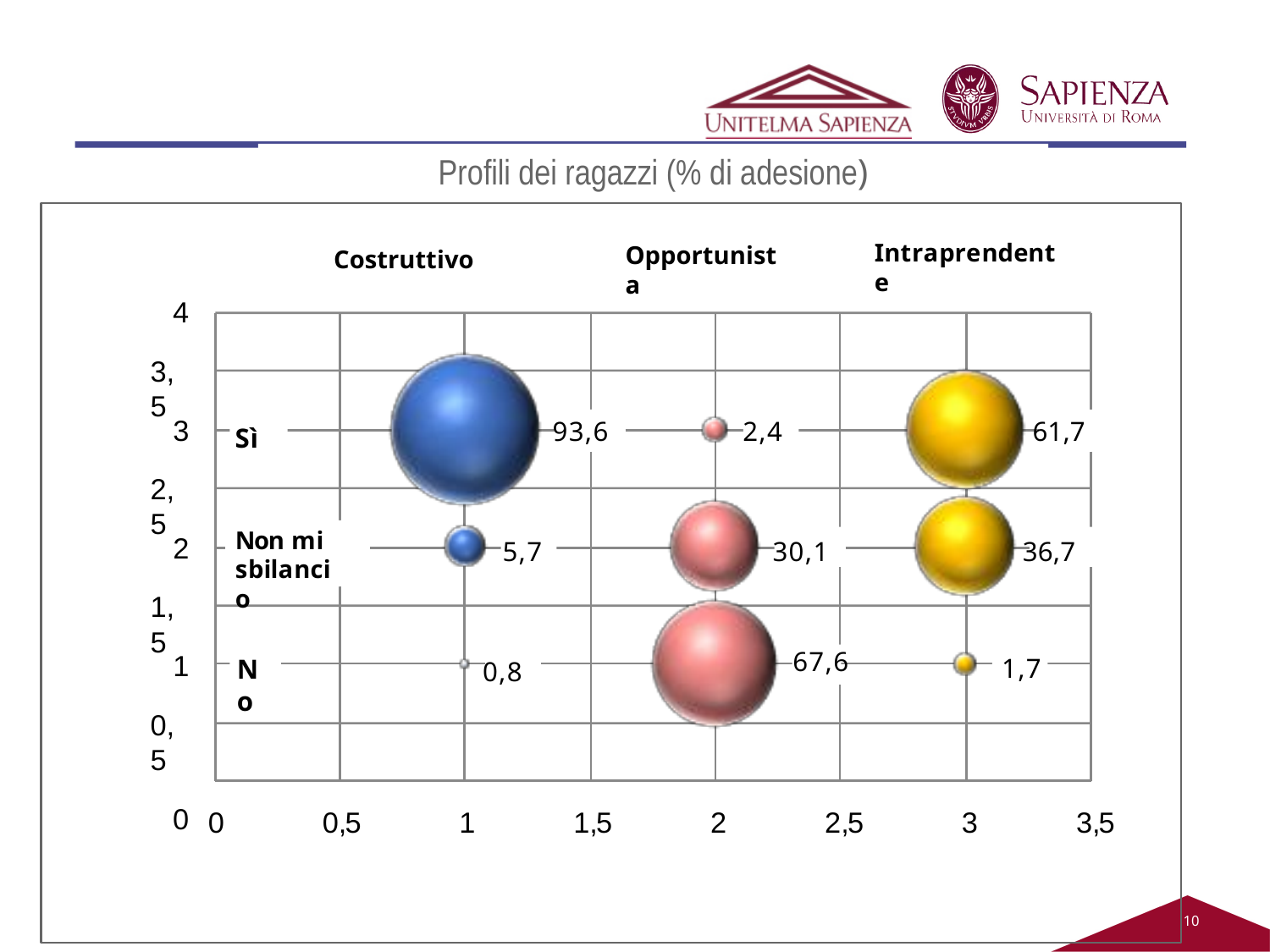
What is the value for Costruttivo in the Sì row? 93,6 Which profile has the largest bubble in the Sì row? Costruttivo What is the total of the three values for Opportunista? 100,1 What is the title of the chart? Profili dei ragazzi (% di adesione) What is the value for Opportunista in the No row? 67,6 What kind of chart is shown on the slide? bubble chart What is the value for Costruttivo in the No row? 0,8 Which profile has the smallest value in the No row? Costruttivo How many profile columns are shown in the chart? 3 What is the value for Intraprendente in the Non mi sbilancio row? 36,7 What is the difference between the Sì values for Costruttivo and Intraprendente? 31,9 Which is larger: the Non mi sbilancio value for Opportunista or for Intraprendente? Intraprendente